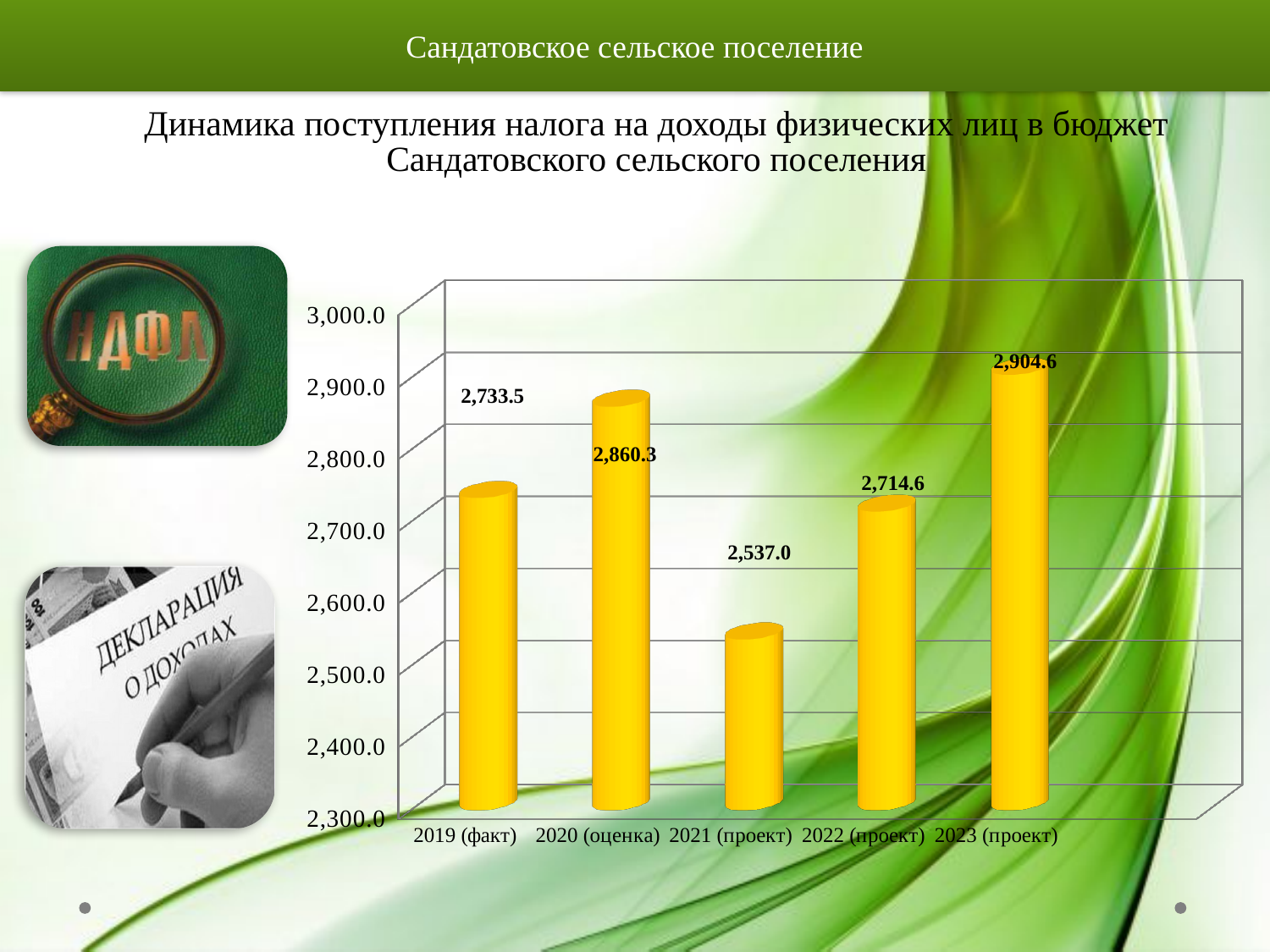
How many categories are shown on the x axis? 5 What is the value for 2023 (проект)? 2,904.6 What is the difference between the values for 2020 (оценка) and 2019 (факт)? 126.8 What colour are the bars in the chart? yellow What is the value for 2021 (проект)? 2,537.0 Which category has the lowest value? 2021 (проект) Which is larger, the value for 2019 (факт) or the value for 2022 (проект)? 2019 (факт) What kind of chart is shown on the slide? bar chart What is the difference between the values for 2023 (проект) and 2021 (проект)? 367.6 Which category has the highest value? 2023 (проект) Is the value for 2020 (оценка) greater or less than 2,800.0? greater What is the value for 2019 (факт)? 2,733.5